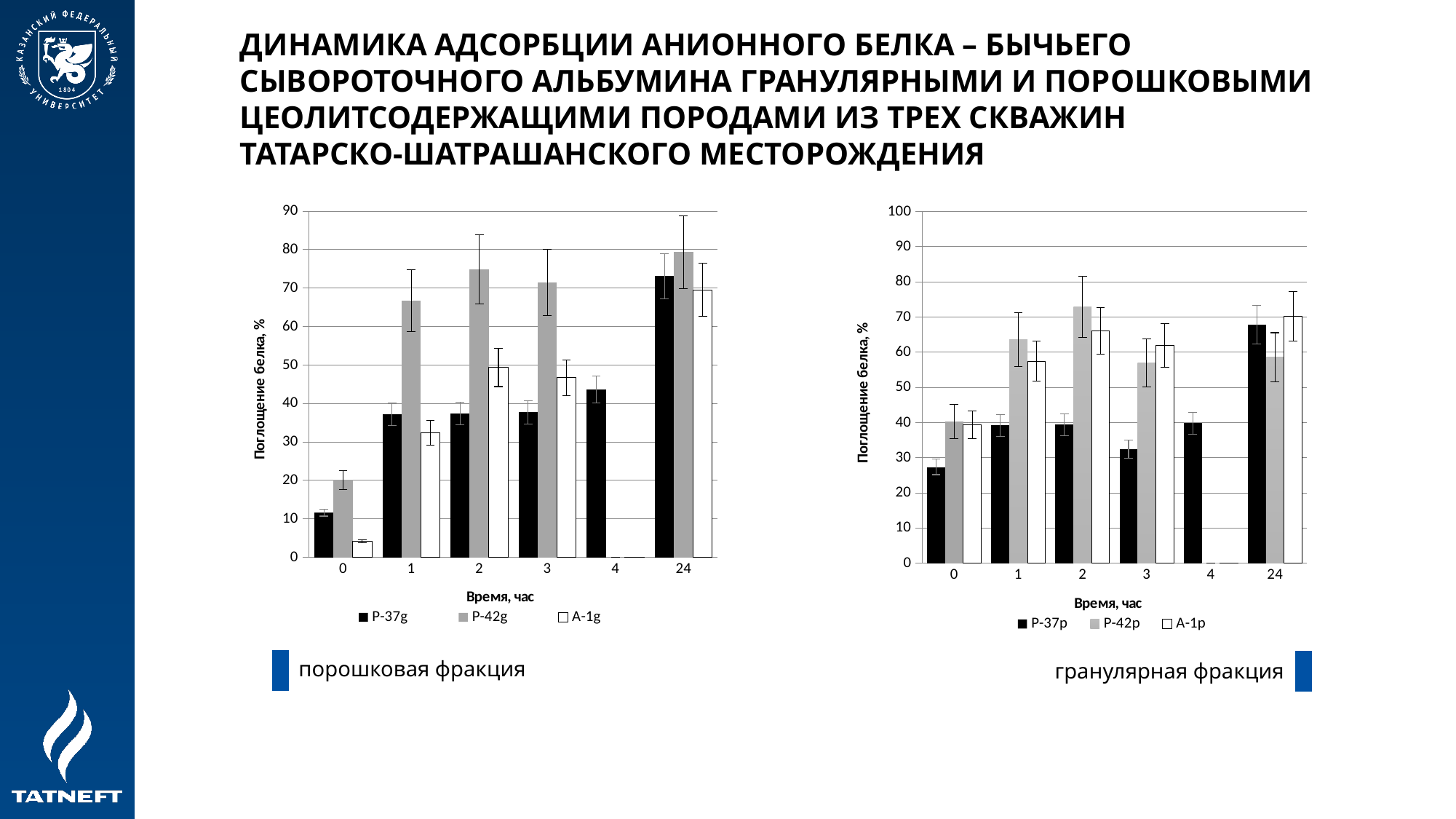
In the right chart, at which time is the value for P-37p highest? 24 In the right chart, is the value for P-37p at time 0 greater or less than 30? less What is the y-axis title of the right chart? Поглощение белка, % In the left chart, is the value for A-1g at time 0 greater or less than 10? less How many series does the legend of the left chart list? 3 How many time categories are shown on the x axis of the right chart (гранулярная фракция)? 6 In the left chart, which series has the highest value at time 2? P-42g In the left chart, is the value for P-42g at time 1 greater or less than 60? greater In the right chart, at time 24, which is larger: P-37p or P-42p? P-37p In the left chart, does the value for P-37g rise or fall from time 0 to time 1? rise What kind of chart is the left chart (порошковая фракция)? bar chart